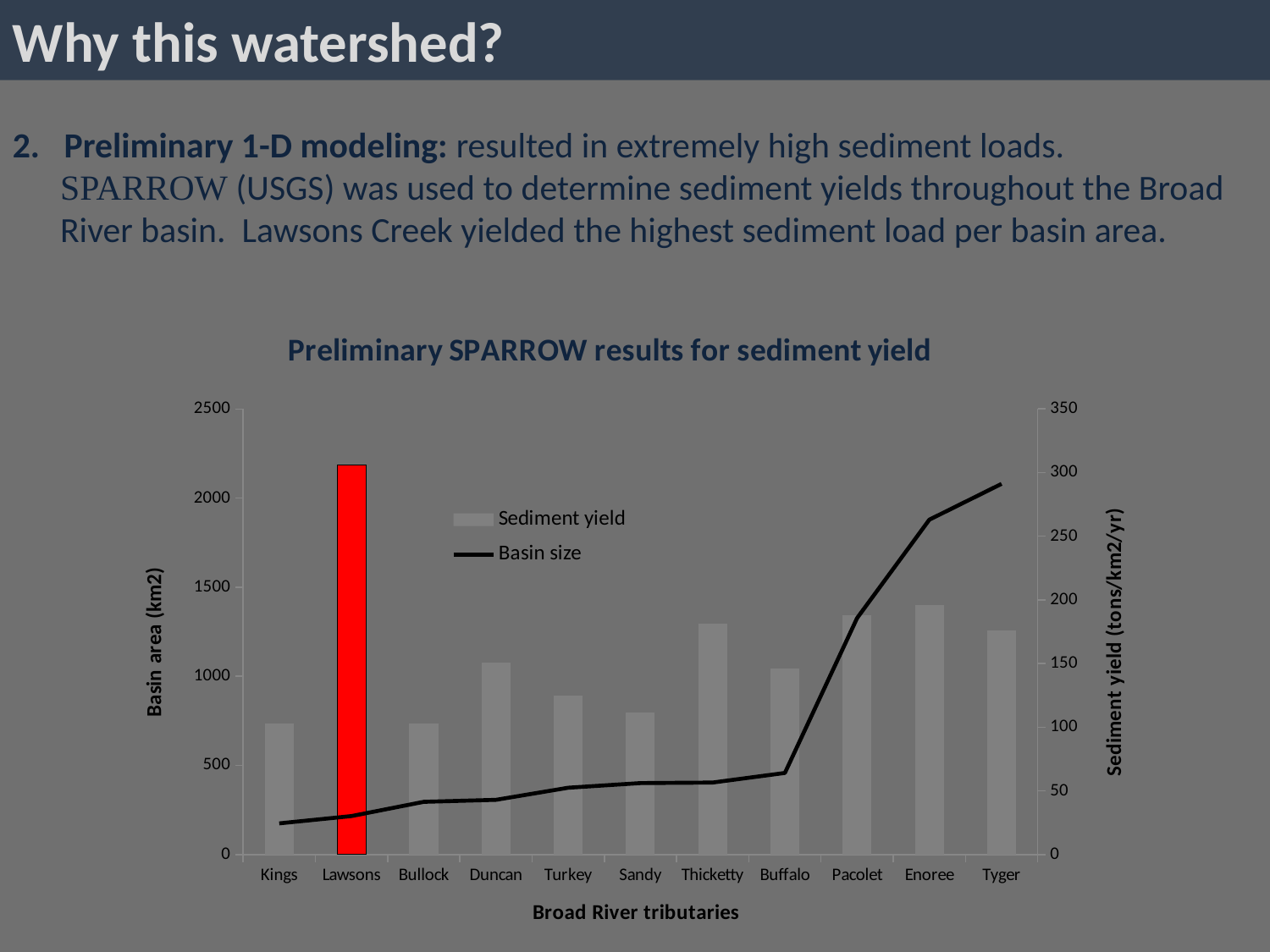
Which has the taller Sediment yield bar, Thicketty or Sandy? Thicketty Which tributary has the tallest Sediment yield bar? Lawsons What is the title of the chart? Preliminary SPARROW results for sediment yield Does the Basin size line generally rise or fall from Kings to Tyger? Rise Which has the taller Sediment yield bar, Lawsons or Enoree? Lawsons Reading against the left axis, is the Lawsons bar greater or less than 2000? greater Which tributary has the highest point on the Basin size line? Tyger What kind of chart is shown on the slide? Combined bar and line chart Which tributary has the lowest point on the Basin size line? Kings Which tributary's bar is highlighted in red? Lawsons How many series does the chart legend list? 2 How many Broad River tributaries are shown on the x axis? 11